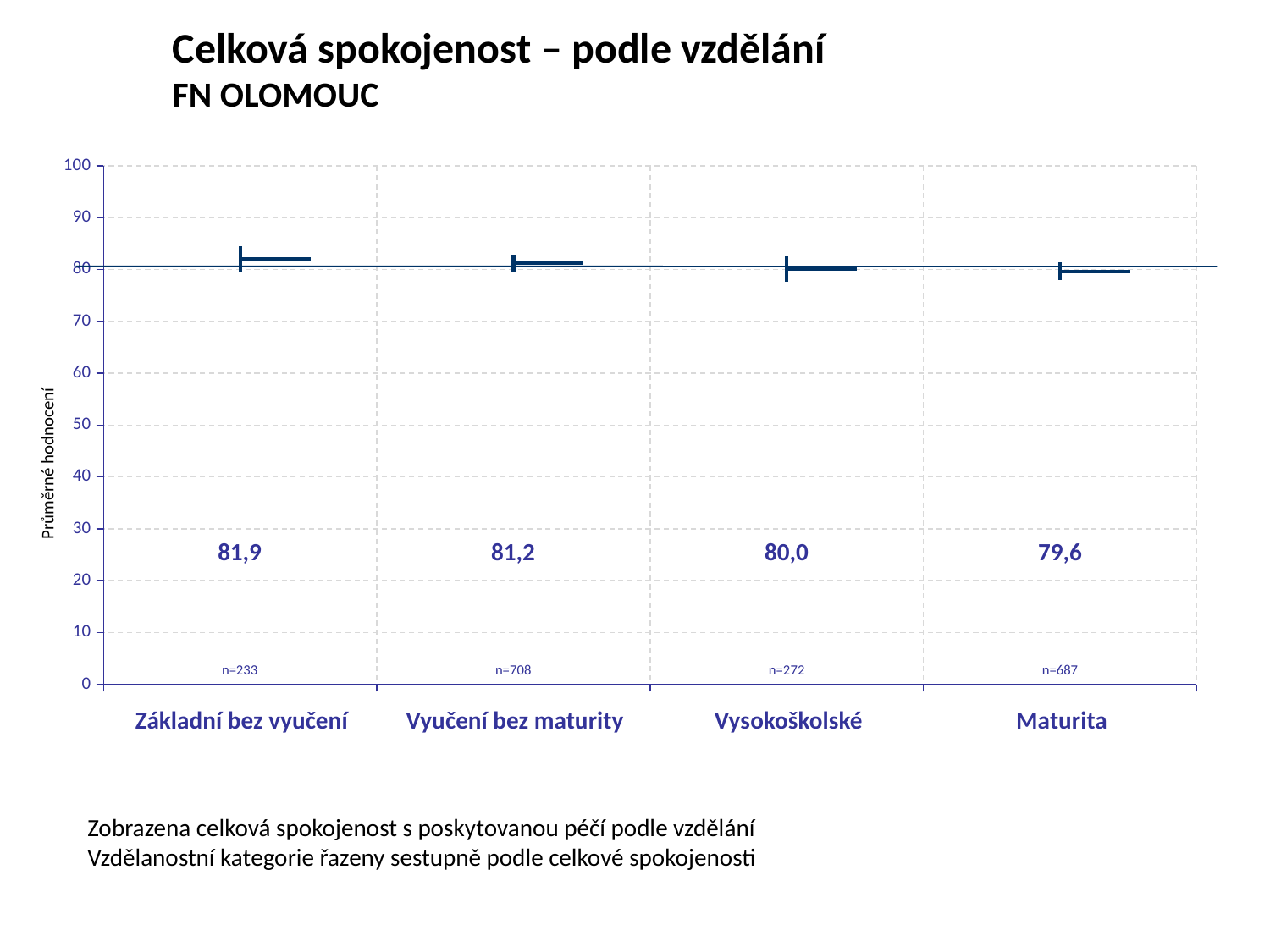
What is the value for Vysokoškolské? 80,0 Which is larger, the value for Vyučení bez maturity or the value for Maturita? Vyučení bez maturity Do the values rise or fall from left to right along the x axis? fall Which category has the highest value? Základní bez vyučení What is the difference between the values for Vyučení bez maturity and Vysokoškolské? 1,2 What is the value for Základní bez vyučení? 81,9 Which category has the lowest value? Maturita How many education categories are shown on the chart? 4 What is the sample size (n) shown for Vyučení bez maturity? n=708 What is the value for Maturita? 79,6 What is the difference between the values for Základní bez vyučení and Maturita? 2,3 What is the value for Vyučení bez maturity? 81,2